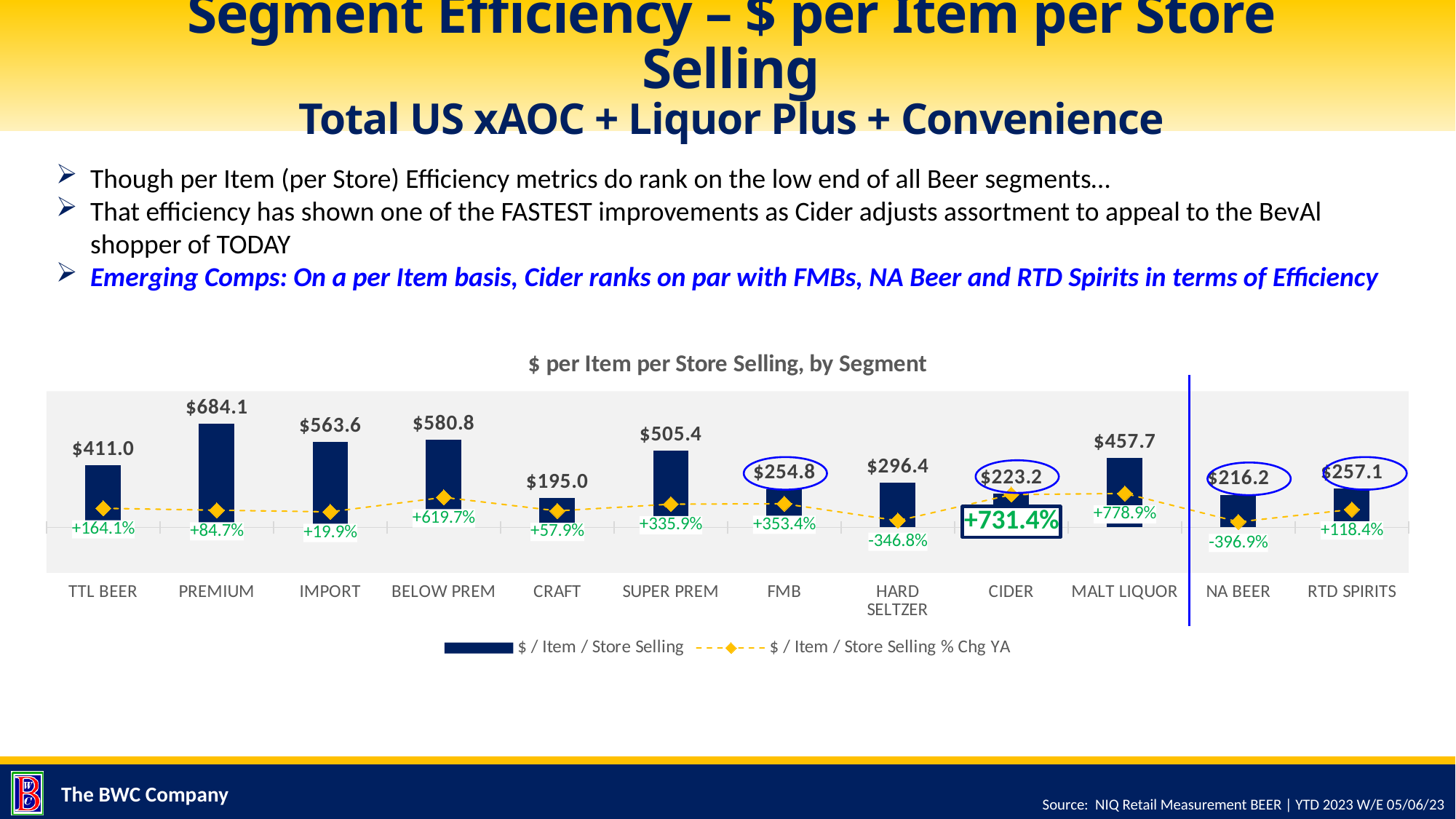
What is the $ / Item / Store Selling % Chg YA for MALT LIQUOR? +778.9% Which segment has the lowest $ / Item / Store Selling value? CRAFT Which segment has the highest $ / Item / Store Selling value? PREMIUM What is the $ / Item / Store Selling value for CIDER? $223.2 Which has a higher $ / Item / Store Selling value, IMPORT or BELOW PREM? BELOW PREM What is the $ / Item / Store Selling % Chg YA for NA BEER? -396.9% What is the $ / Item / Store Selling value for PREMIUM? $684.1 What kind of chart is used to show $ / Item / Store Selling by segment? Bar chart with a line for % Chg YA How many segments are shown on the x axis of the chart? 12 What is the title of the chart? $ per Item per Store Selling, by Segment How many series does the chart legend list? 2 What is the difference in $ / Item / Store Selling between PREMIUM and CIDER? $460.9